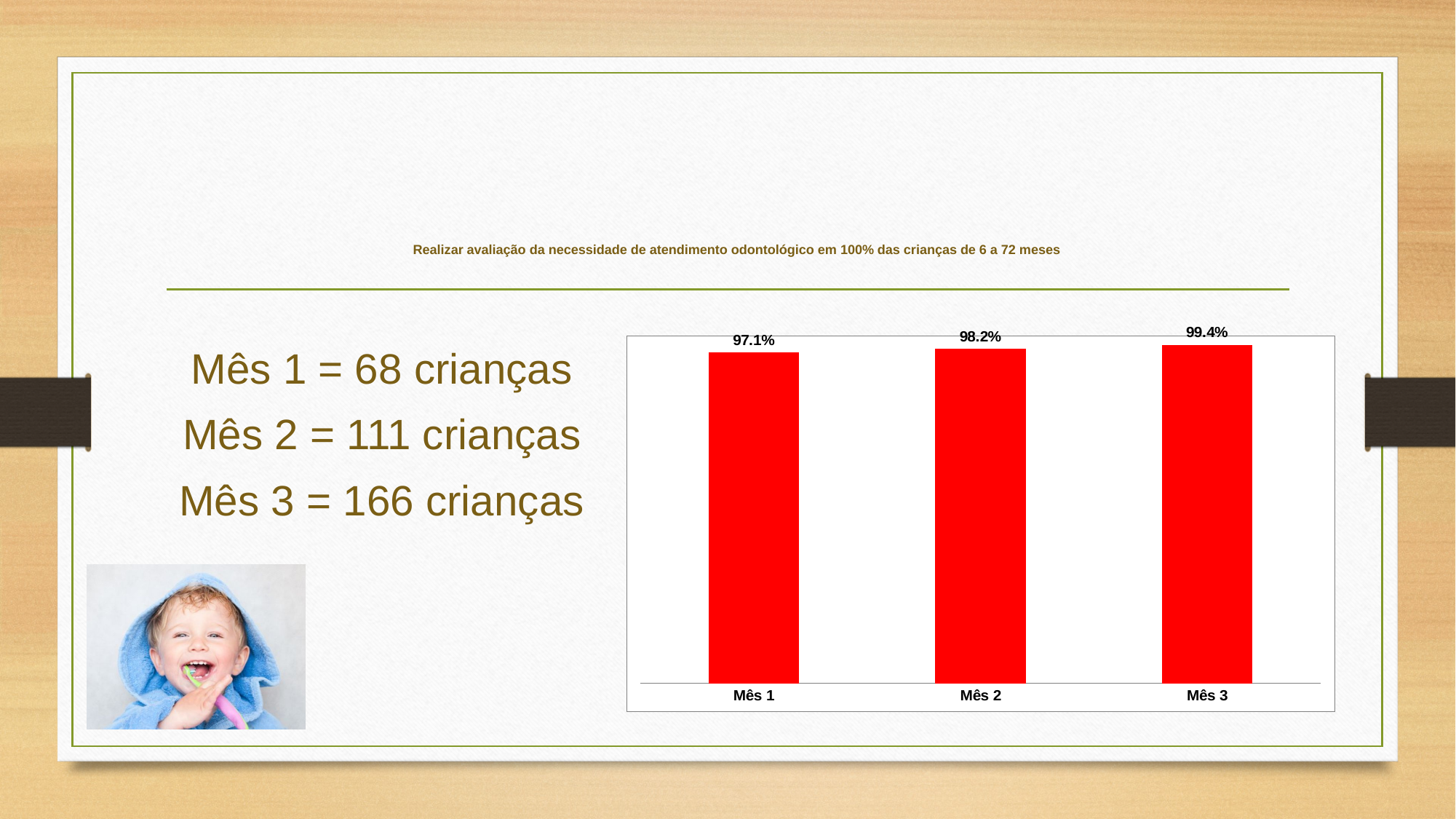
What is the difference between the values for Mês 2 and Mês 1? 1.1% What is the value for Mês 2? 98.2% What is the value for Mês 3? 99.4% Which is larger, the value for Mês 2 or the value for Mês 3? Mês 3 Do the values rise or fall from Mês 1 to Mês 3? Rise What is the value for Mês 1? 97.1% What is the difference between the values for Mês 3 and Mês 1? 2.3% Which month has the highest value? Mês 3 What kind of chart is shown on the slide? Bar chart What colour are the bars in the chart? Red How many categories are shown on the chart? 3 Which month has the lowest value? Mês 1